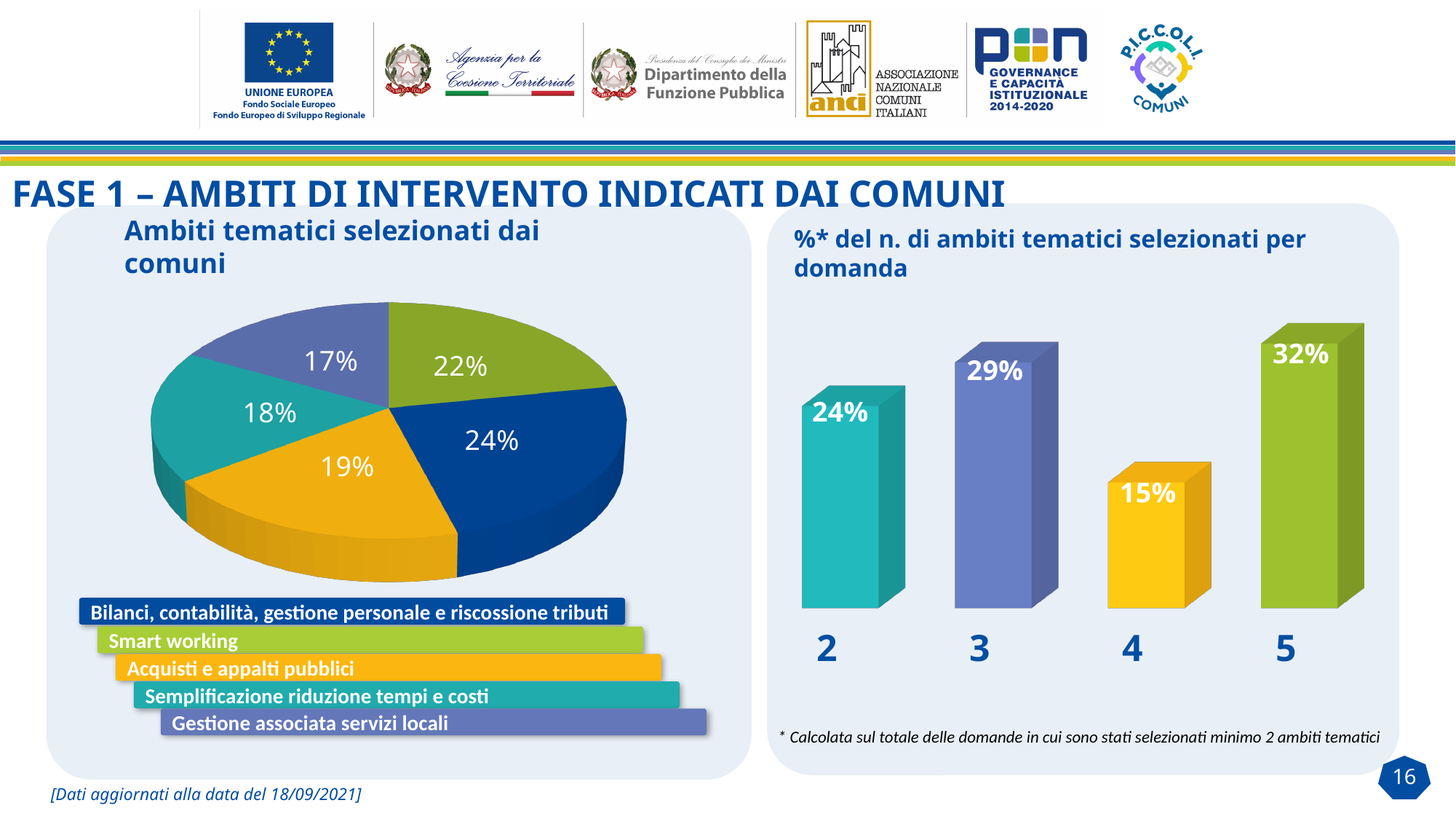
In the pie chart 'Ambiti tematici selezionati dai comuni', which category has the largest slice? Bilanci, contabilità, gestione personale e riscossione tributi In the pie chart 'Ambiti tematici selezionati dai comuni', which category has the smallest slice? Gestione associata servizi locali What kind of chart is the one on the right of the slide, titled '%* del n. di ambiti tematici selezionati per domanda'? Bar chart In the pie chart 'Ambiti tematici selezionati dai comuni', what share does 'Bilanci, contabilità, gestione personale e riscossione tributi' have? 24% In the bar chart '%* del n. di ambiti tematici selezionati per domanda', which category has the lowest value? 4 In the pie chart 'Ambiti tematici selezionati dai comuni', what share does 'Smart working' have? 22% In the bar chart '%* del n. di ambiti tematici selezionati per domanda', what is the difference between the values for category 5 and category 2? 8% In the pie chart 'Ambiti tematici selezionati dai comuni', how many categories are shown? 5 In the bar chart '%* del n. di ambiti tematici selezionati per domanda', which category has the highest value? 5 In the pie chart 'Ambiti tematici selezionati dai comuni', what share does 'Gestione associata servizi locali' have? 17% In the bar chart '%* del n. di ambiti tematici selezionati per domanda', what is the value for category 3? 29% In the pie chart 'Ambiti tematici selezionati dai comuni', what is the difference between the shares of 'Acquisti e appalti pubblici' and 'Semplificazione riduzione tempi e costi'? 1%